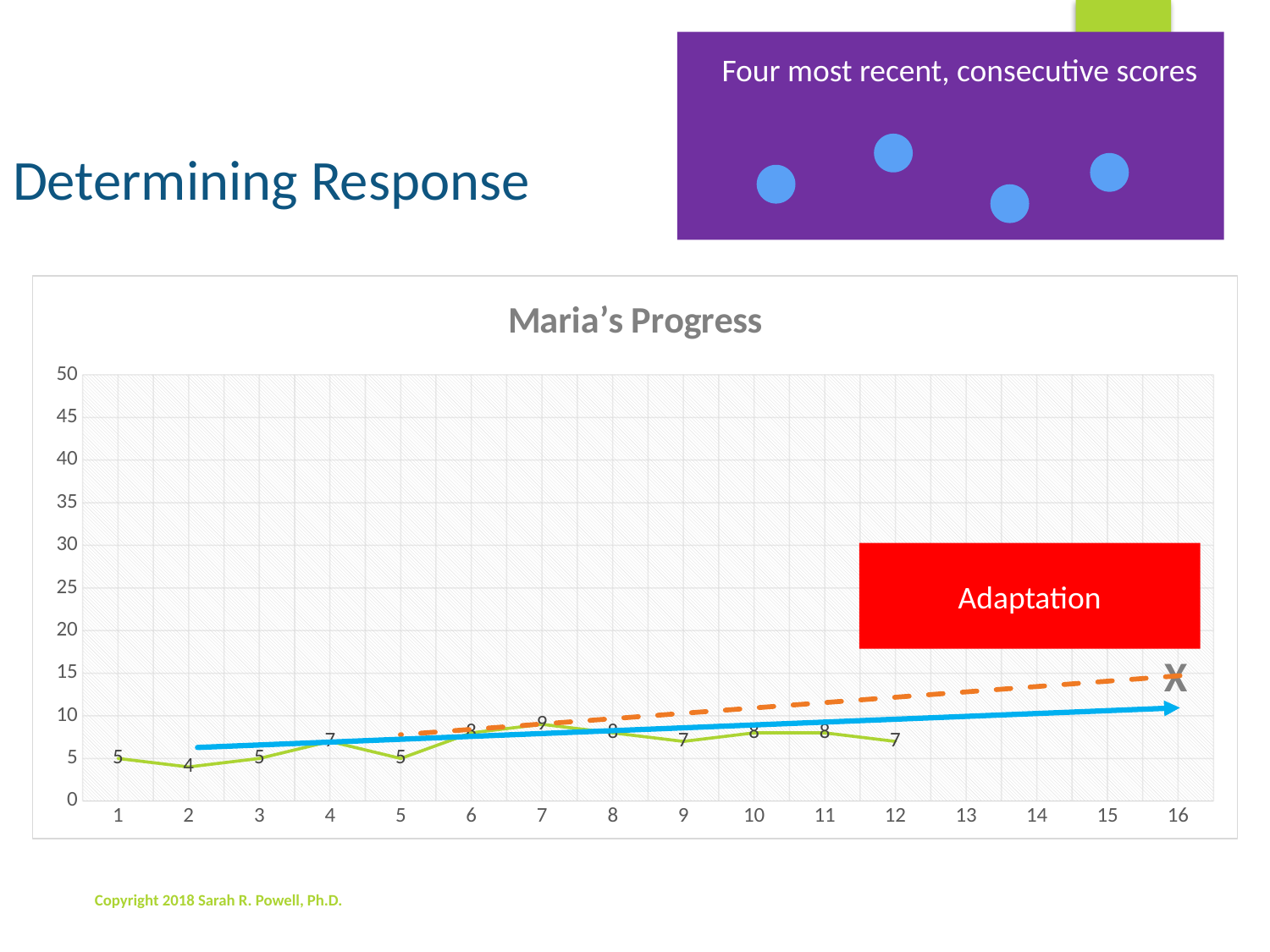
Which is larger, Maria's score at point 4 or at point 5? point 4 At which point on the x axis is Maria's score lowest? 2 How many points are labelled along the x axis? 16 What word appears in the red box on the chart? Adaptation At which point on the x axis is Maria's score highest? 7 Is Maria's score at point 11 greater or less than 10? less What is the difference between Maria's score at point 7 and her score at point 2? 5 What is Maria's score at point 1? 5 What is the title of the chart? Maria's Progress What type of chart is shown on the slide? line chart What is Maria's score at point 7? 9 What is Maria's score at point 12? 7